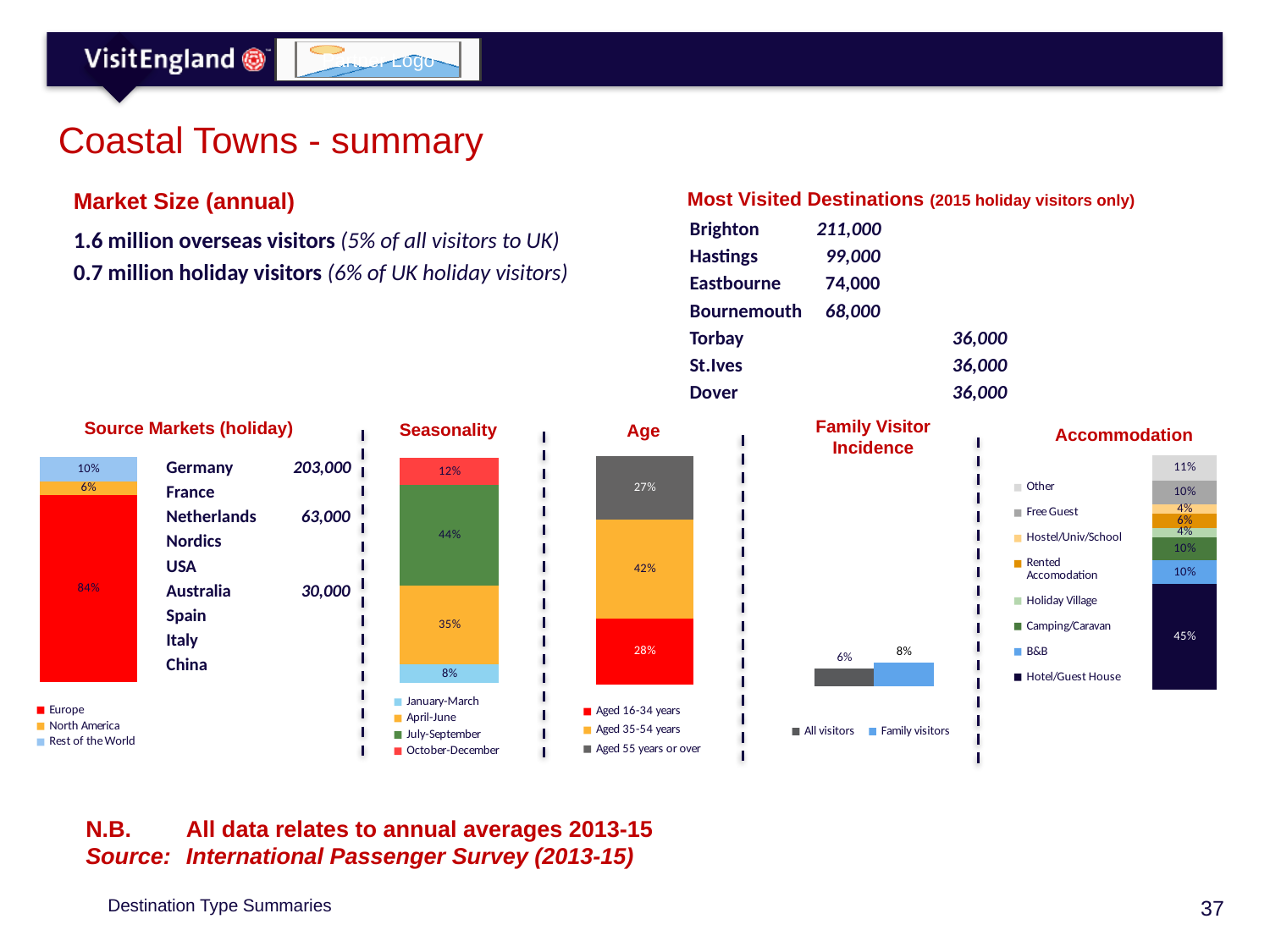
In the Seasonality chart, what is the difference between the July-September and April-June shares? 9 percentage points In the Seasonality chart, which quarter has the lowest share of visits? January-March How many series does the legend of the Family Visitor Incidence chart list? 2 In the Accommodation chart, what percentage is shown for Camping/Caravan? 10% In the Source Markets (holiday) chart, what percentage of holiday visitors come from Europe? 84% In the Accommodation chart, which accommodation type has the largest share? Hotel/Guest House In the Seasonality chart, which quarter has the highest share of visits? July-September In the Age chart, what percentage of visitors are aged 35-54 years? 42% How many accommodation types does the legend of the Accommodation chart list? 8 In the Age chart, which is larger: the share aged 16-34 years or the share aged 55 years or over? Aged 16-34 years In the Family Visitor Incidence chart, what is the value for Family visitors? 8% In the Source Markets (holiday) chart, what percentage is shown for Rest of the World? 10%